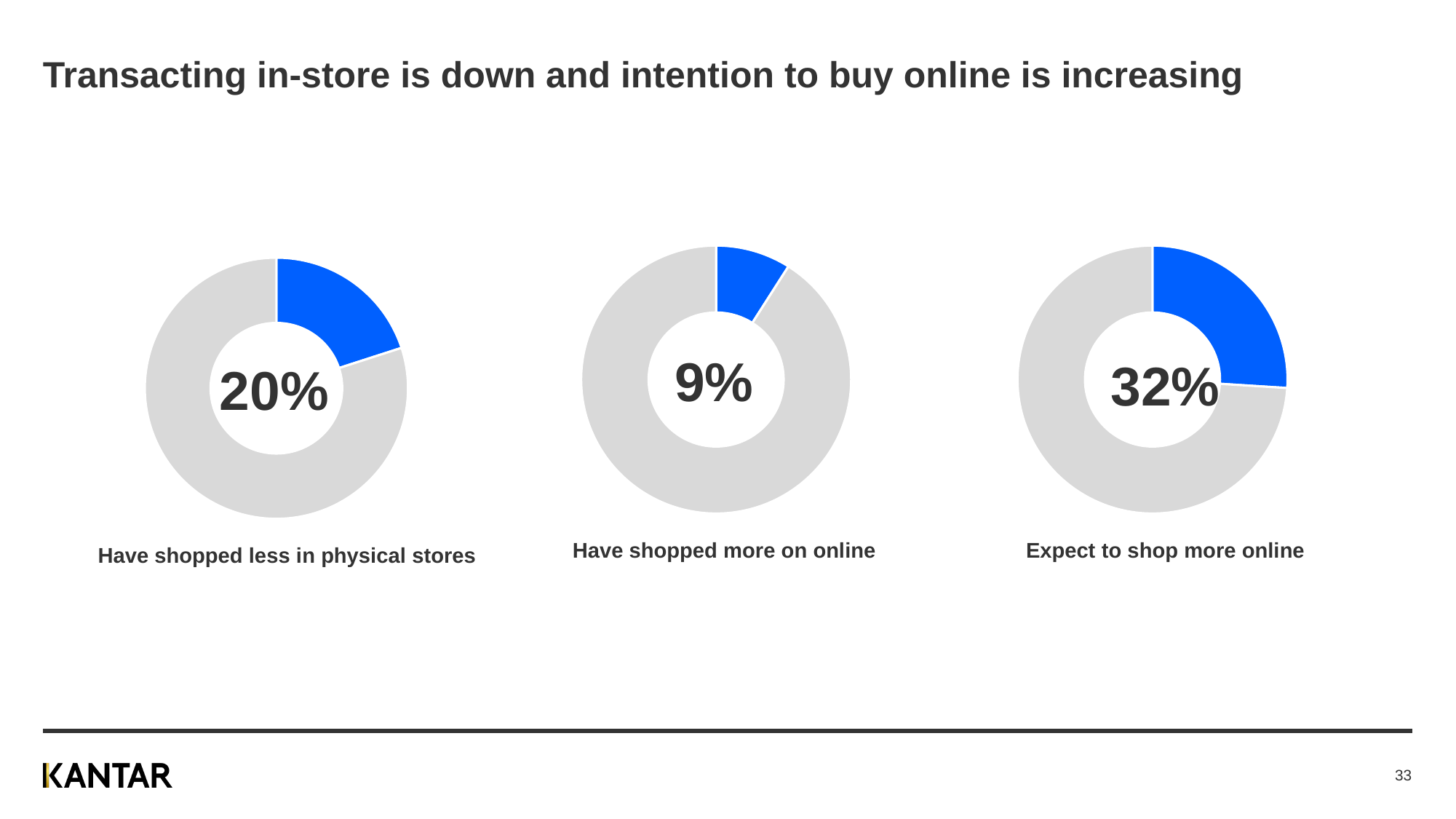
What colour is used for the highlighted segment in each donut chart? Blue How many donut charts are shown on the slide? 3 What percentage of respondents have shopped less in physical stores? 20% What is the title of the slide? Transacting in-store is down and intention to buy online is increasing What percentage of respondents expect to shop more online? 32% What is the difference between the percentage who expect to shop more online and the percentage who have shopped more online? 23% What kind of chart is used to show each percentage on the slide? Donut (pie) chart What is the difference between the percentage who have shopped less in physical stores and the percentage who have shopped more online? 11% Which of the three statements has the lowest percentage? Have shopped more on online Which of the three statements has the highest percentage? Expect to shop more online What percentage of respondents have shopped more online? 9% Which is larger: the percentage who have shopped less in physical stores or the percentage who expect to shop more online? Expect to shop more online